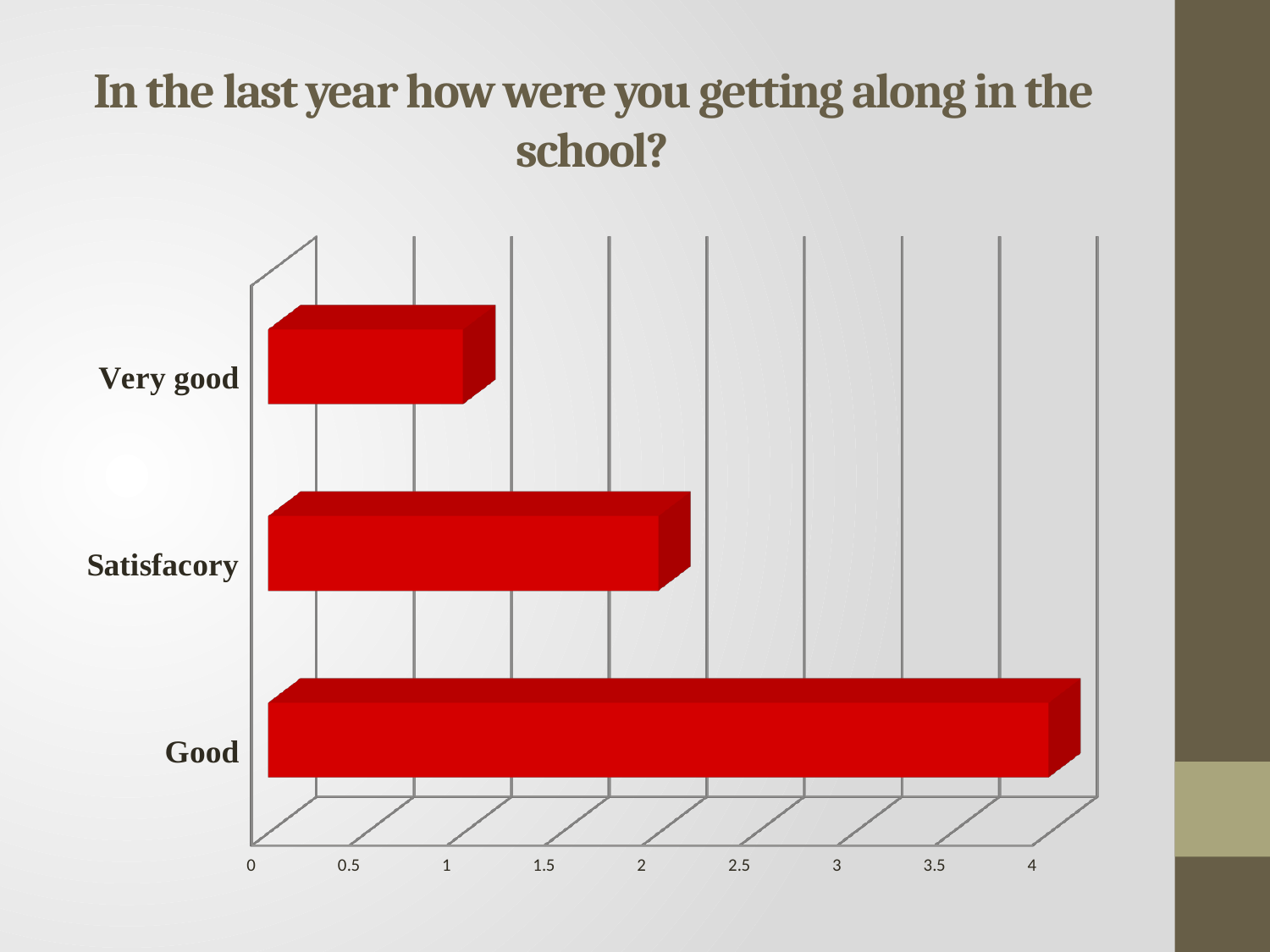
Is the value for Very good greater or less than 2? less Which category has the lowest value? Very good Is the value for Good greater or less than 3? greater Which has the larger value, Good or Satisfacory? Good Which has the larger value, Satisfacory or Very good? Satisfacory What is the highest tick value shown on the horizontal axis? 4 What kind of chart is shown on the slide? bar chart How many categories are plotted in the chart? 3 Is the value for Satisfacory greater or less than 3? less Which category has the highest value? Good What is the title of the chart? In the last year how were you getting along in the school?